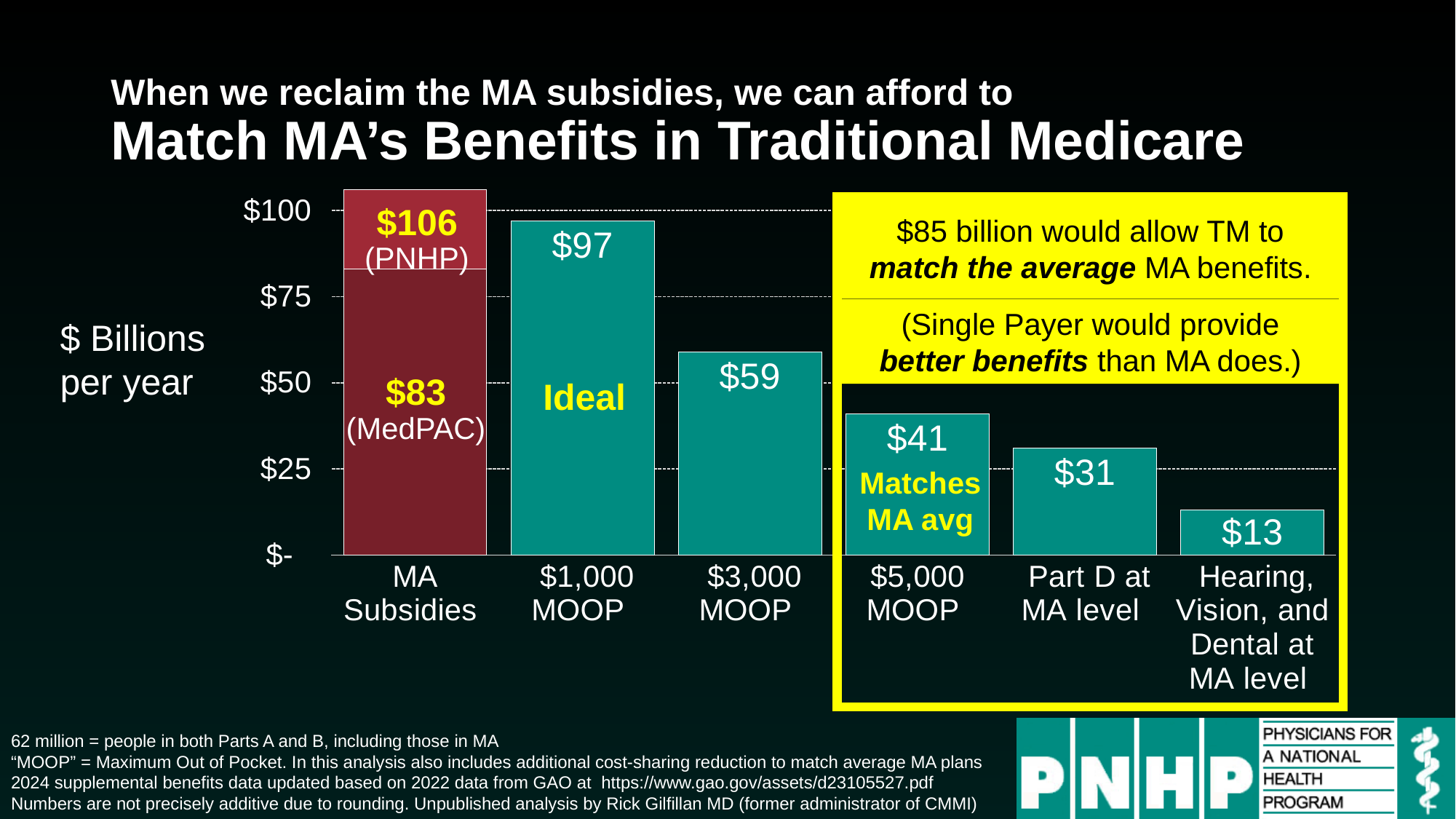
What is the value for the $5,000 MOOP bar? $41 Which is larger, the $5,000 MOOP value or the Part D at MA level value? $5,000 MOOP What is the MedPAC estimate of MA Subsidies shown on the MA Subsidies bar? $83 What is the value for the $3,000 MOOP bar? $59 How many categories are shown on the x axis? 6 What is the difference between the $1,000 MOOP value and the $3,000 MOOP value? $38 What is the value for Hearing, Vision, and Dental at MA level? $13 Which category has the lowest value? Hearing, Vision, and Dental at MA level What is the value for Part D at MA level? $31 What kind of chart is shown on the slide? Bar chart What is the value for the $1,000 MOOP bar? $97 What is the PNHP estimate of MA Subsidies shown on the MA Subsidies bar? $106